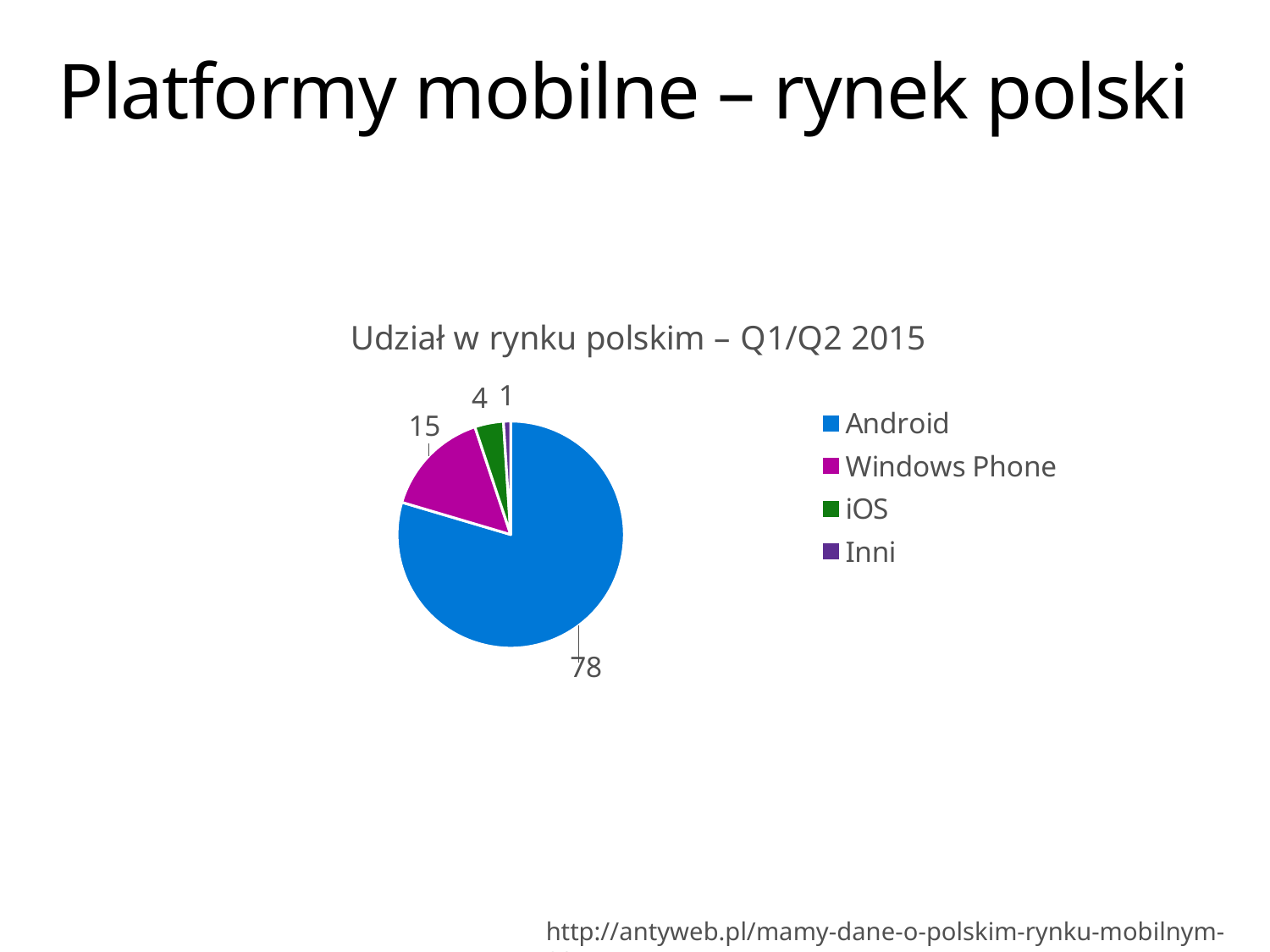
What is the value for Windows Phone in the pie chart? 15 What is the value for Android in the pie chart? 78 What is the value for Inni in the pie chart? 1 How many categories does the pie chart show? 4 Which category has the smallest slice of the pie chart? Inni Which category has the largest slice of the pie chart? Android What is the title of the chart? Udział w rynku polskim – Q1/Q2 2015 Which is larger, the value for Windows Phone or the value for iOS? Windows Phone What is the difference between the values for Android and Windows Phone? 63 What colour is the Windows Phone slice in the pie chart? Magenta What kind of chart is shown on the slide? Pie chart What is the value for iOS in the pie chart? 4